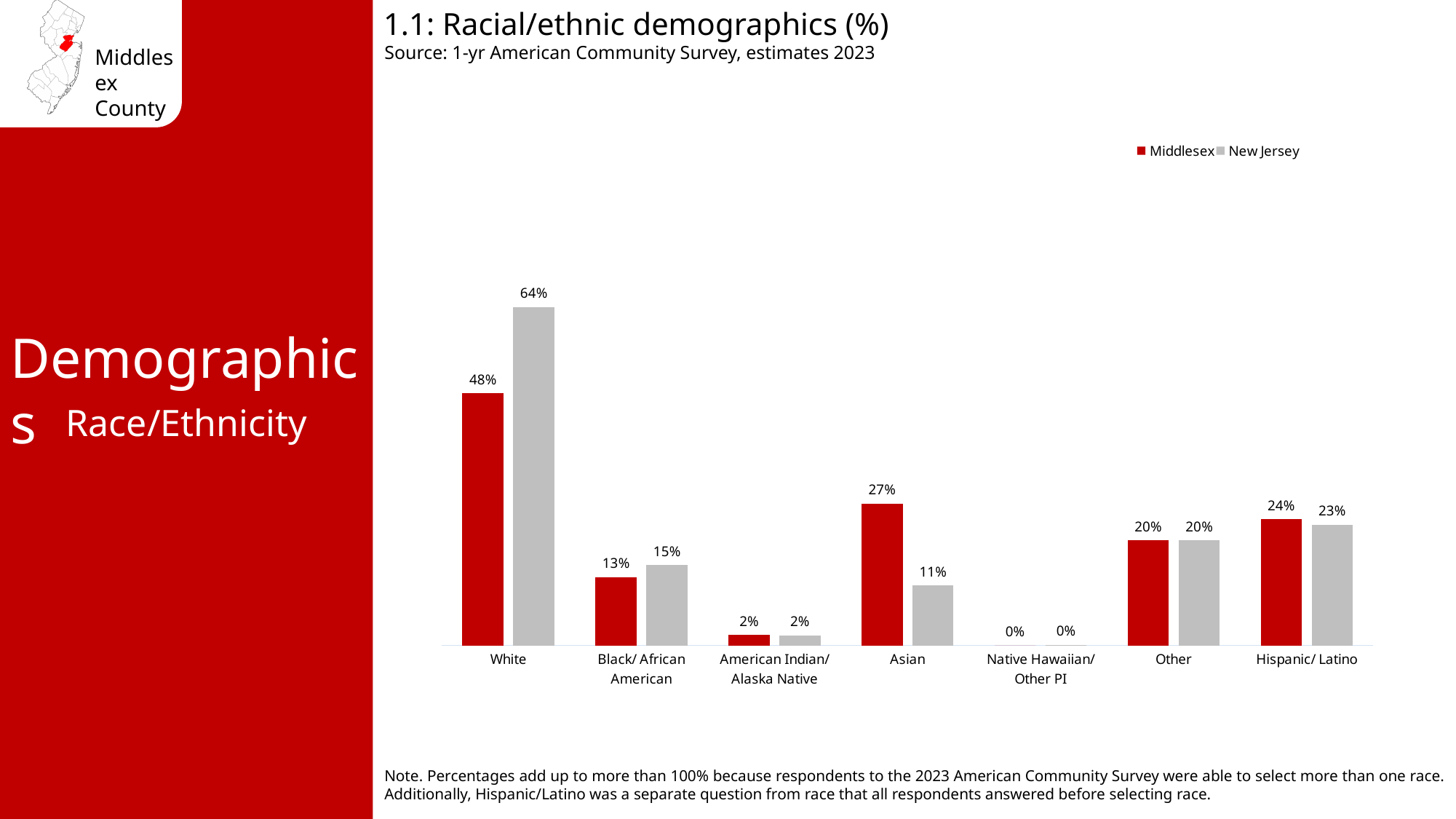
Which category has the highest New Jersey value? White What is the difference between the New Jersey and Middlesex values for White? 16% Which is larger for Black/ African American: Middlesex or New Jersey? New Jersey What kind of chart is shown? Bar chart How many categories are shown on the x axis? 7 Which category has the lowest Middlesex value? Native Hawaiian/ Other PI What is the difference between the Middlesex and New Jersey values for Asian? 16% What is the New Jersey value for Asian? 11% What is the Middlesex value for Hispanic/ Latino? 24% What is the Middlesex value for White? 48% How many series does the legend list? 2 What colour represents Middlesex in the chart? Red